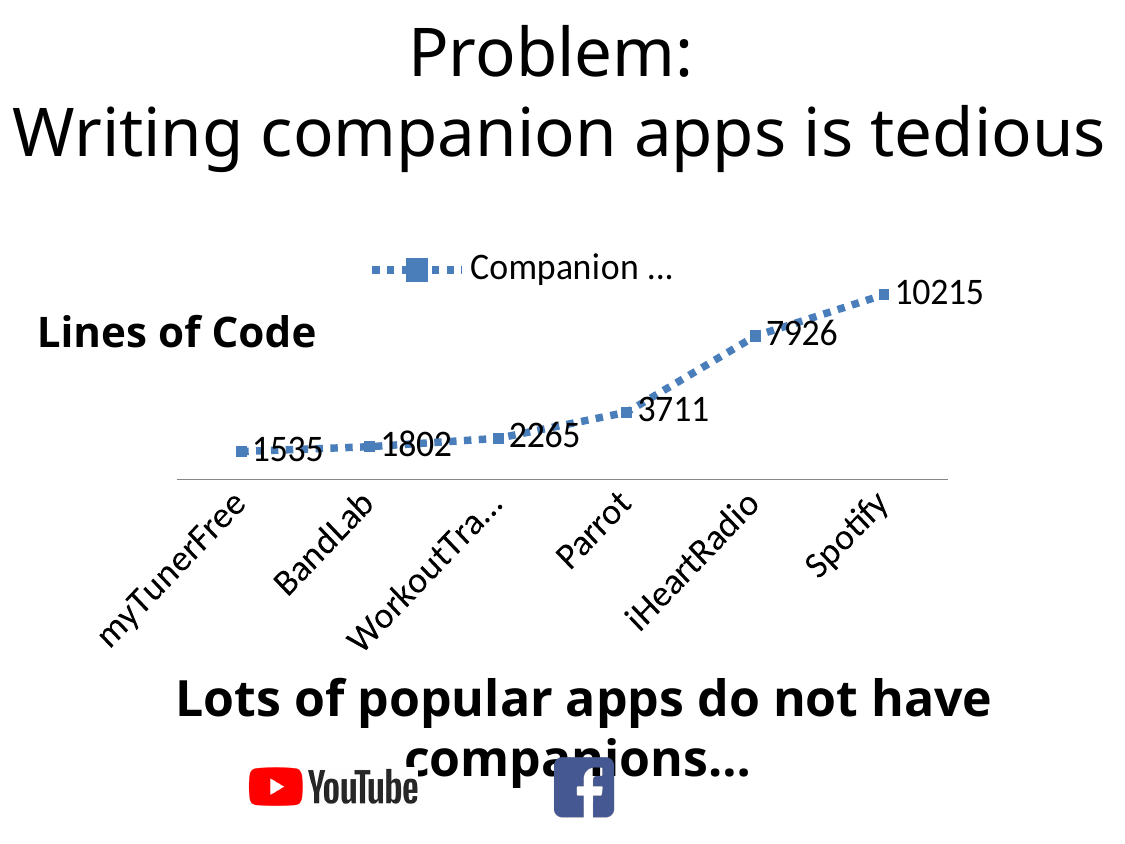
What is the value for iHeartRadio? 7926 What kind of chart is shown on the slide? line chart What is the value for BandLab? 1802 Which app has the highest value? Spotify What is the value for Parrot? 3711 What is the difference between the values for Spotify and iHeartRadio? 2289 What is the value for Spotify? 10215 Which is larger, the value for Parrot or the value for iHeartRadio? iHeartRadio Do the values rise or fall from left to right along the x axis? rise What is the difference between the values for Parrot and BandLab? 1909 Which app has the lowest value? myTunerFree How many apps are plotted on the chart? 6